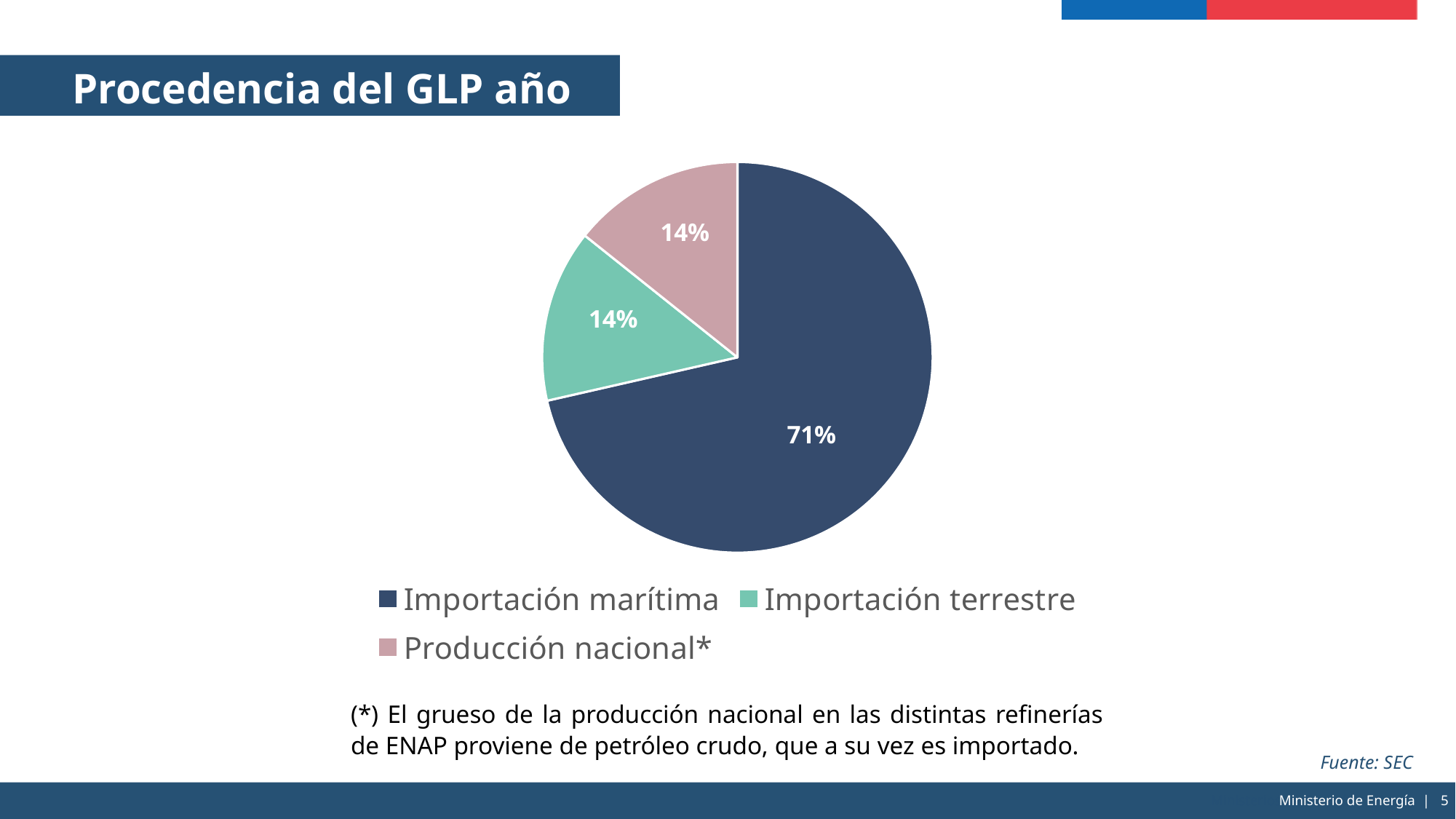
What is the difference in percentage points between Importación marítima and Importación terrestre? 57 percentage points What share of the pie does Producción nacional* represent? 14% What is the combined share of Importación terrestre and Producción nacional*? 28% How many slices does the pie chart have? 3 Which is larger, the slice for Importación marítima or the slice for Producción nacional*? Importación marítima Which category has the largest slice of the pie? Importación marítima What kind of chart is shown on the slide? Pie chart How many entries does the legend list? 3 What share of the pie does Importación terrestre represent? 14% What colour is the slice for Importación terrestre? Green What is the title of the slide containing the chart? Procedencia del GLP año What share of the pie does Importación marítima represent? 71%